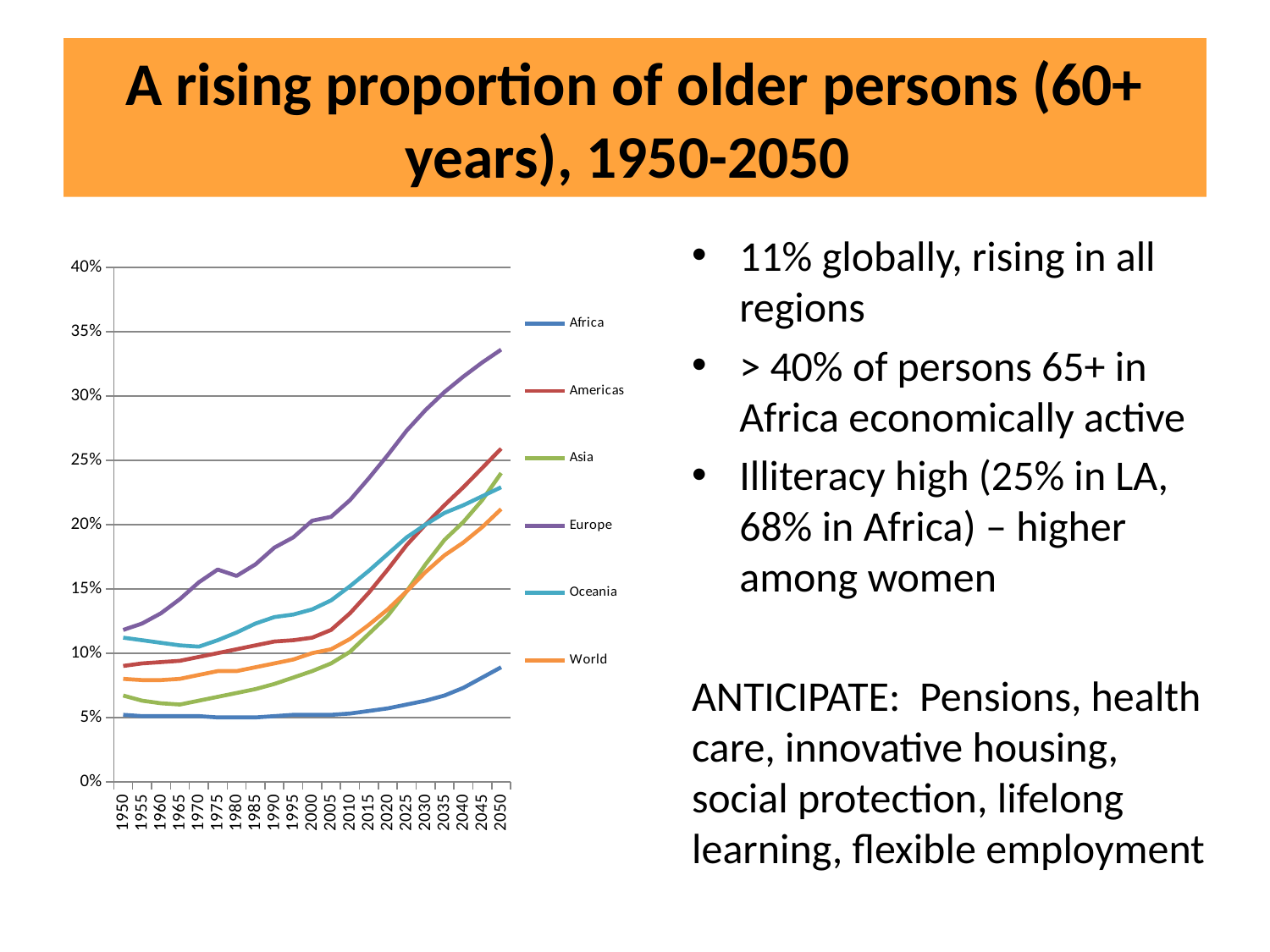
What kind of chart is shown on the slide? line chart Is the value for Asia in 1950 greater or less than 10%? less What colour is the line for Europe in the chart? purple In 1950, which is larger: the value for Americas or the value for Asia? Americas How many years are marked along the x axis of the chart? 21 Which series has the highest value in 2050? Europe Does the value for Europe rise or fall from 1950 to 2050? rise Which series has the lowest value in 2050? Africa Is the value for Europe in 2050 greater or less than 30%? greater Is the value for Africa in 1950 greater or less than 10%? less How many series does the chart's legend list? 6